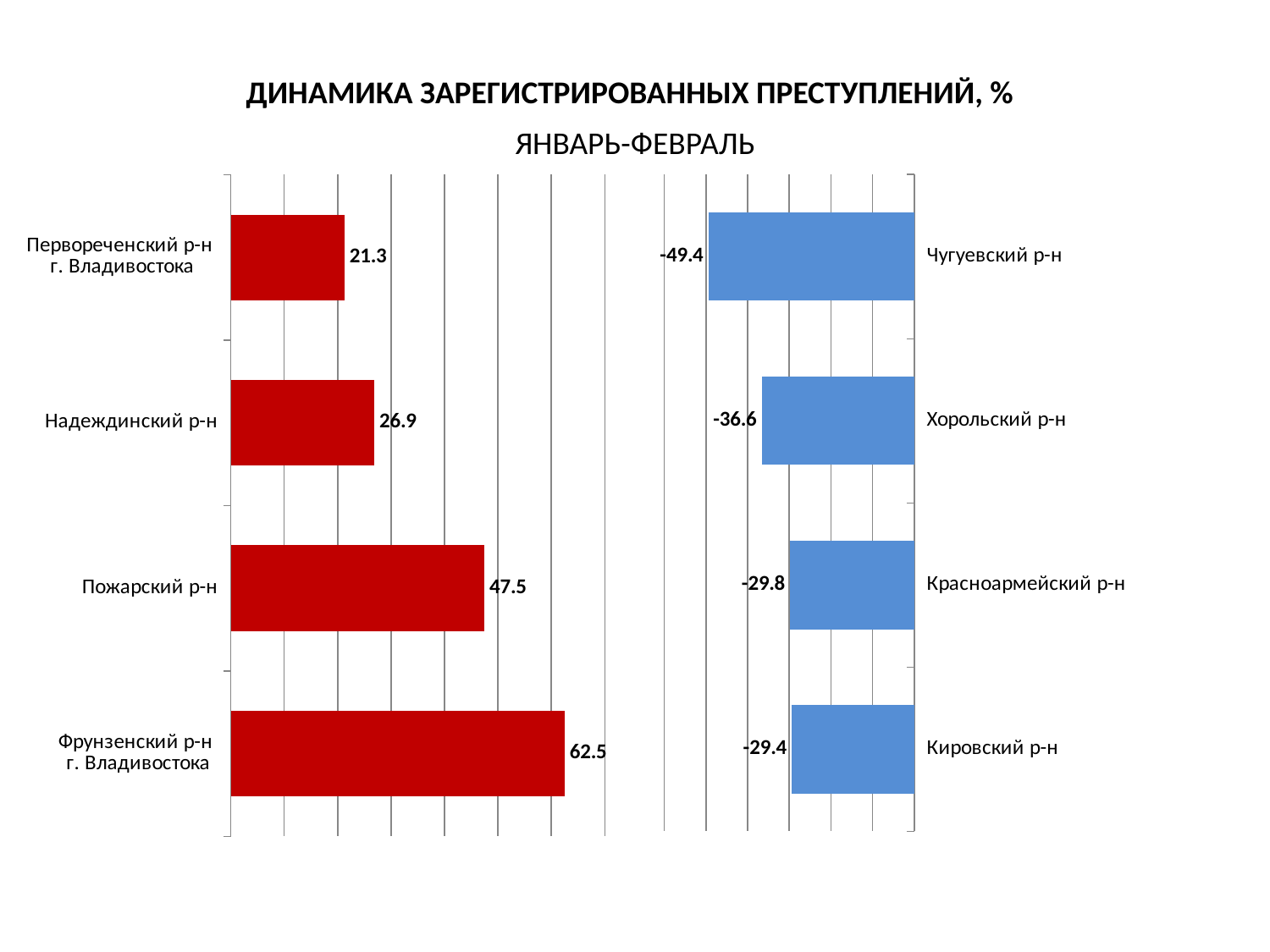
What type of chart is used on the left side of the slide? Bar chart On the left chart, what is the value for Пожарский р-н? 47.5 On the right chart, what is the value for Кировский р-н? -29.4 On the left chart, which district has the lowest value? Первореченский р-н г. Владивостока On the left chart, which is larger: the value for Пожарский р-н or the value for Надеждинский р-н? Пожарский р-н On the left chart, what is the value for Первореченский р-н г. Владивостока? 21.3 On the right chart, what is the difference between the values for Чугуевский р-н and Хорольский р-н? 12.8 On the right chart, which district has the lowest value? Чугуевский р-н On the left chart, what is the difference between the values for Фрунзенский р-н г. Владивостока and Надеждинский р-н? 35.6 On the right chart, what is the value for Хорольский р-н? -36.6 How many districts are shown on the right chart? 4 On the left chart, which district has the highest value? Фрунзенский р-н г. Владивостока